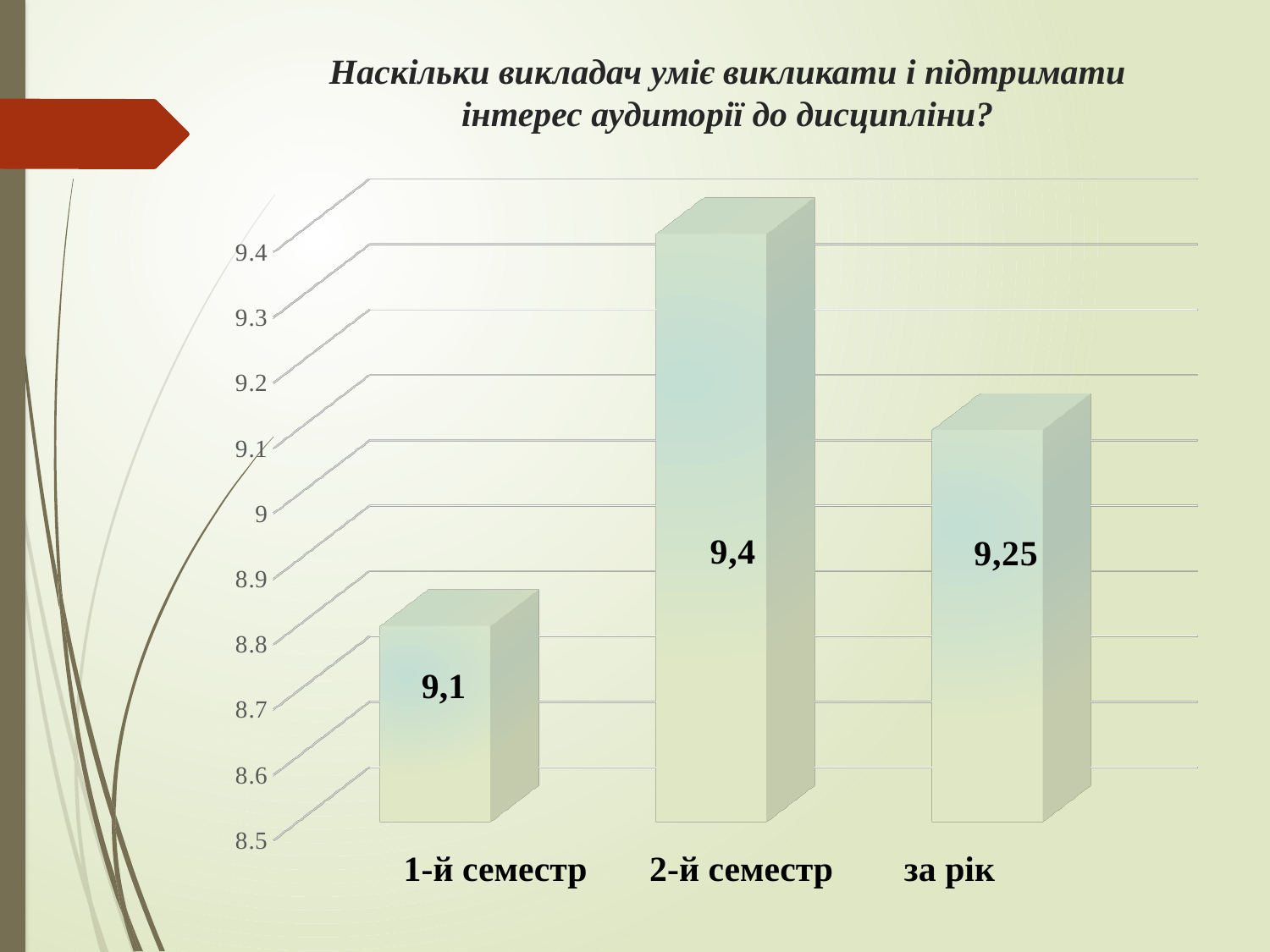
Which category has the lowest value? 1-й семестр What is the difference between the values for за рік and 1-й семестр? 0,15 Is the value for 2-й семестр greater or less than 9.3? greater What is the title of the chart? Наскільки викладач уміє викликати і підтримати інтерес аудиторії до дисципліни? What is the value for за рік? 9,25 What is the value for 2-й семестр? 9,4 Which is larger, the value for за рік or the value for 1-й семестр? за рік How many categories are shown on the x axis? 3 What is the value for 1-й семестр? 9,1 Which category has the highest value? 2-й семестр What is the difference between the values for 2-й семестр and 1-й семестр? 0,3 What kind of chart is shown on the slide? bar chart